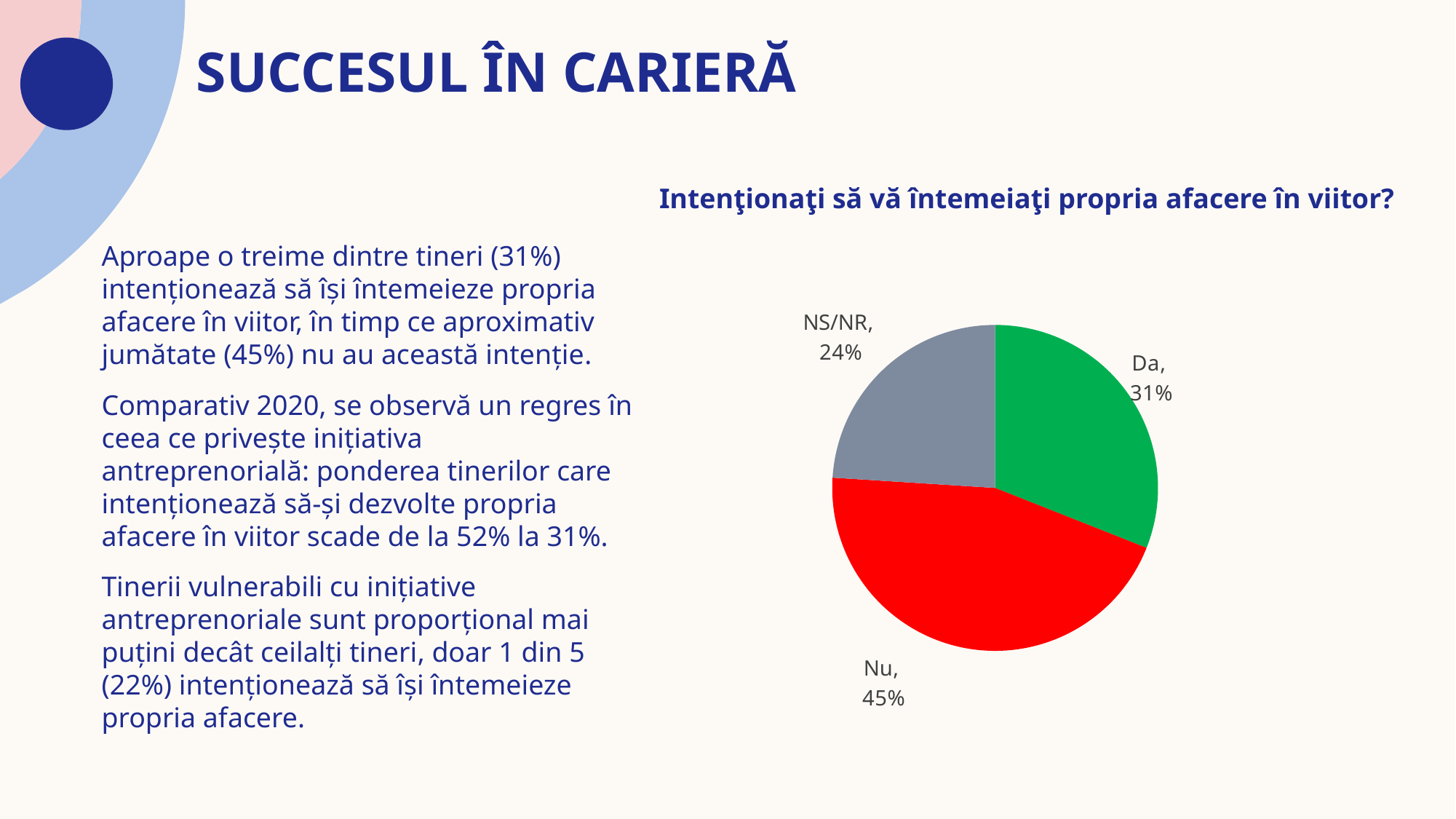
What is the value for "Da" in the pie chart? 31% Which category has the smallest share of the pie chart? NS/NR What type of chart is shown on the slide? pie chart How many slices does the pie chart have? 3 What is the value for "NS/NR" in the pie chart? 24% What is the difference between the "Da" and "NS/NR" shares? 7% Which category has the largest share of the pie chart? Nu What is the difference between the "Nu" and "Da" shares? 14% What is the value for "Nu" in the pie chart? 45% Which is larger, the share for "Da" or the share for "NS/NR"? Da What colour is the "Nu" slice in the pie chart? red What is the title of the pie chart? Intenţionaţi să vă întemeiaţi propria afacere în viitor?